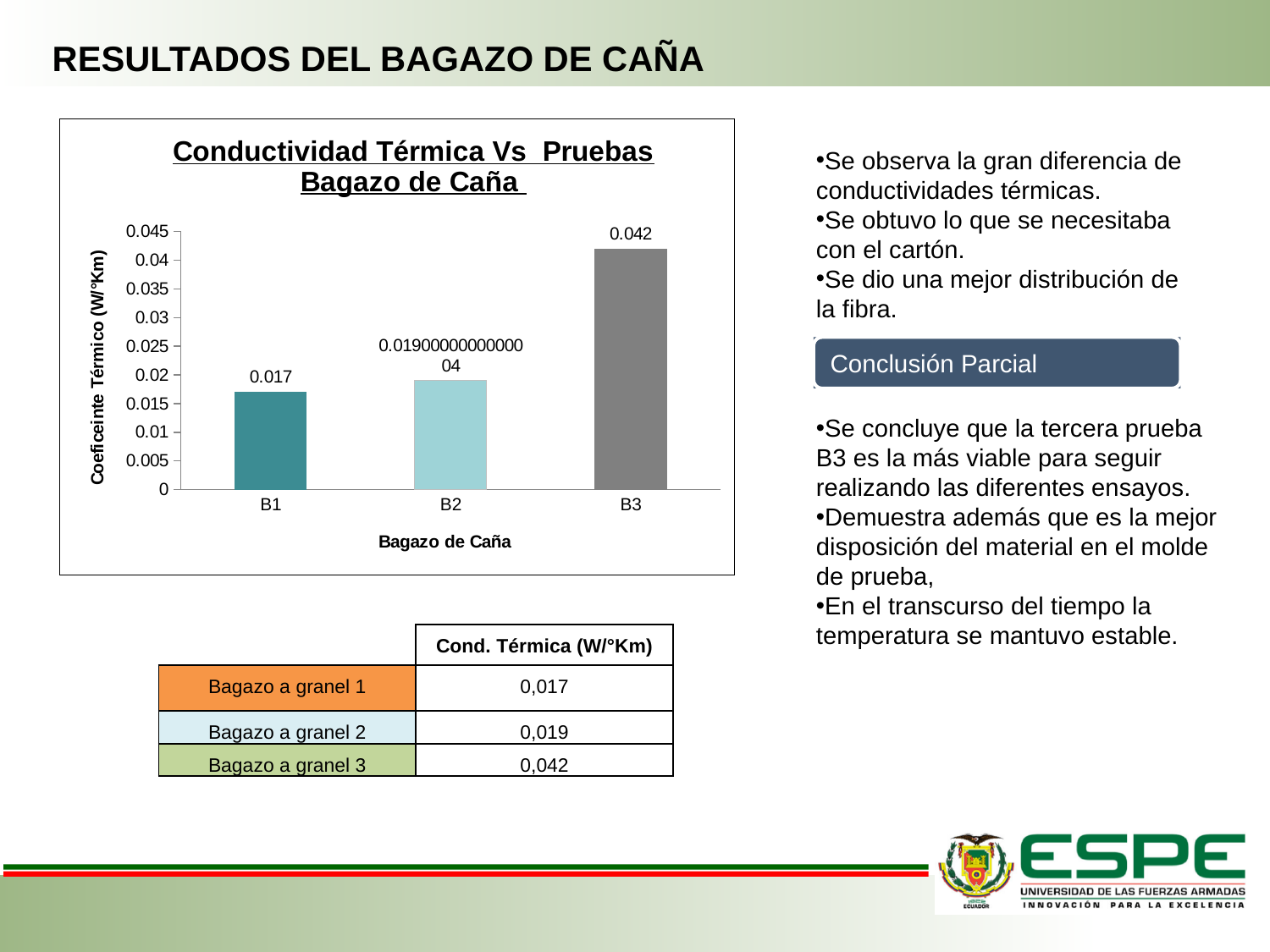
Do the values rise or fall from B1 to B3 along the x axis? rise How many categories are shown on the x axis of the chart? 3 Which category has the lowest value in the chart? B1 What is the title of the chart? Conductividad Térmica Vs Pruebas Bagazo de Caña Is the value for B3 greater or less than 0.04? greater Which is larger, the value for B2 or the value for B3? B3 What kind of chart is shown on the slide? bar chart What is the difference between the values for B3 and B1? 0.025 What is the value for B1 in the chart? 0.017 Which category has the highest value in the chart? B3 Is the value for B2 greater or less than 0.02? less What is the value for B3 in the chart? 0.042